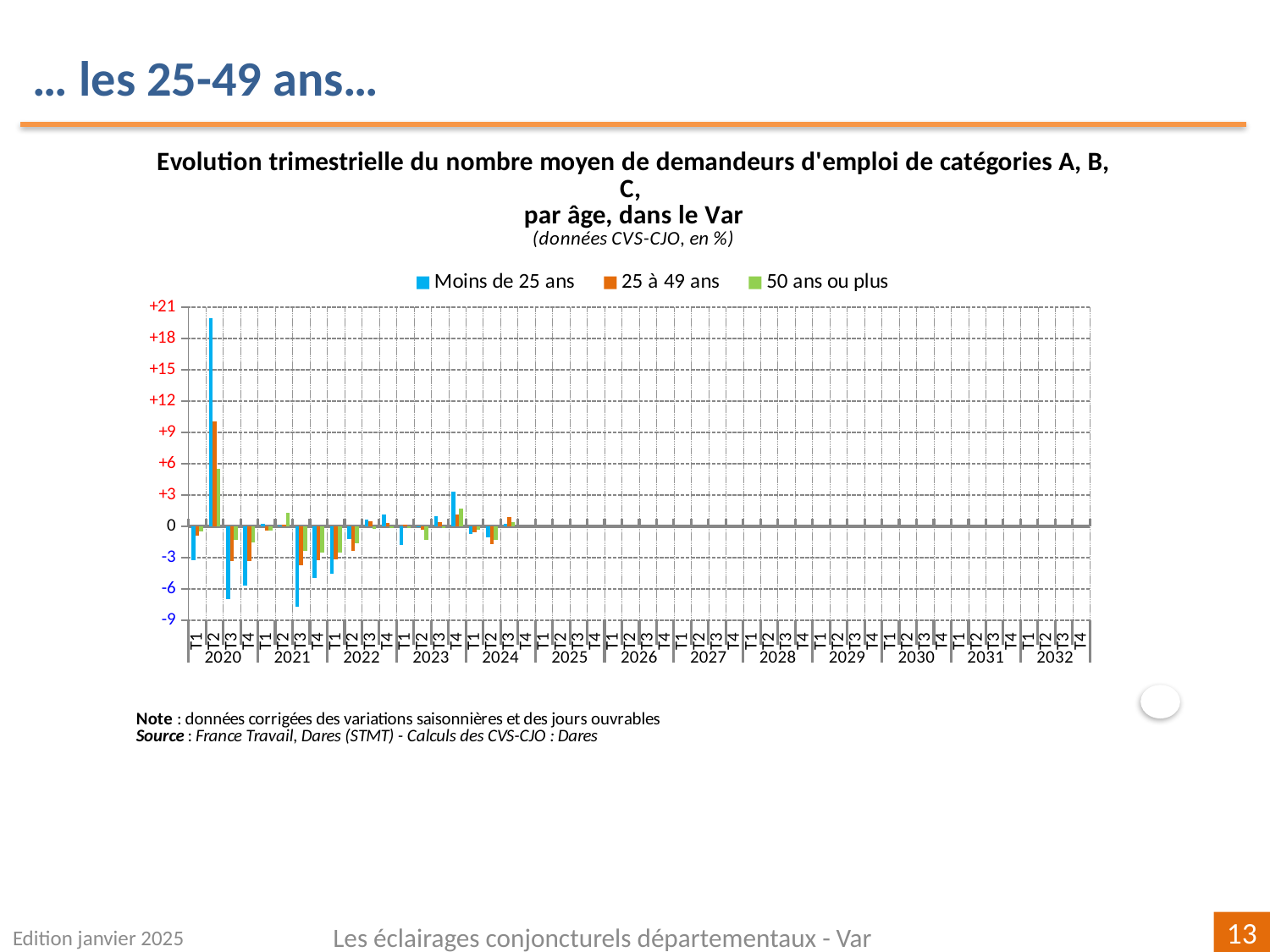
What kind of chart is shown on the slide? Bar chart Is the value for 'Moins de 25 ans' in T3 2020 greater or less than -6? less How many series does the legend list? 3 Which series are listed in the legend? Moins de 25 ans, 25 à 49 ans, 50 ans ou plus In which quarter does the 'Moins de 25 ans' series reach its highest value? T2 2020 In T2 2020, which series has the larger value: 'Moins de 25 ans' or '50 ans ou plus'? Moins de 25 ans Is the value for 'Moins de 25 ans' in T2 2020 greater or less than +18? greater Which colour represents the '25 à 49 ans' series? Orange Is the value for '25 à 49 ans' in T3 2021 greater or less than -3? less In which quarter does the 'Moins de 25 ans' series reach its lowest value? T3 2021 What is the highest value shown on the vertical axis? +21